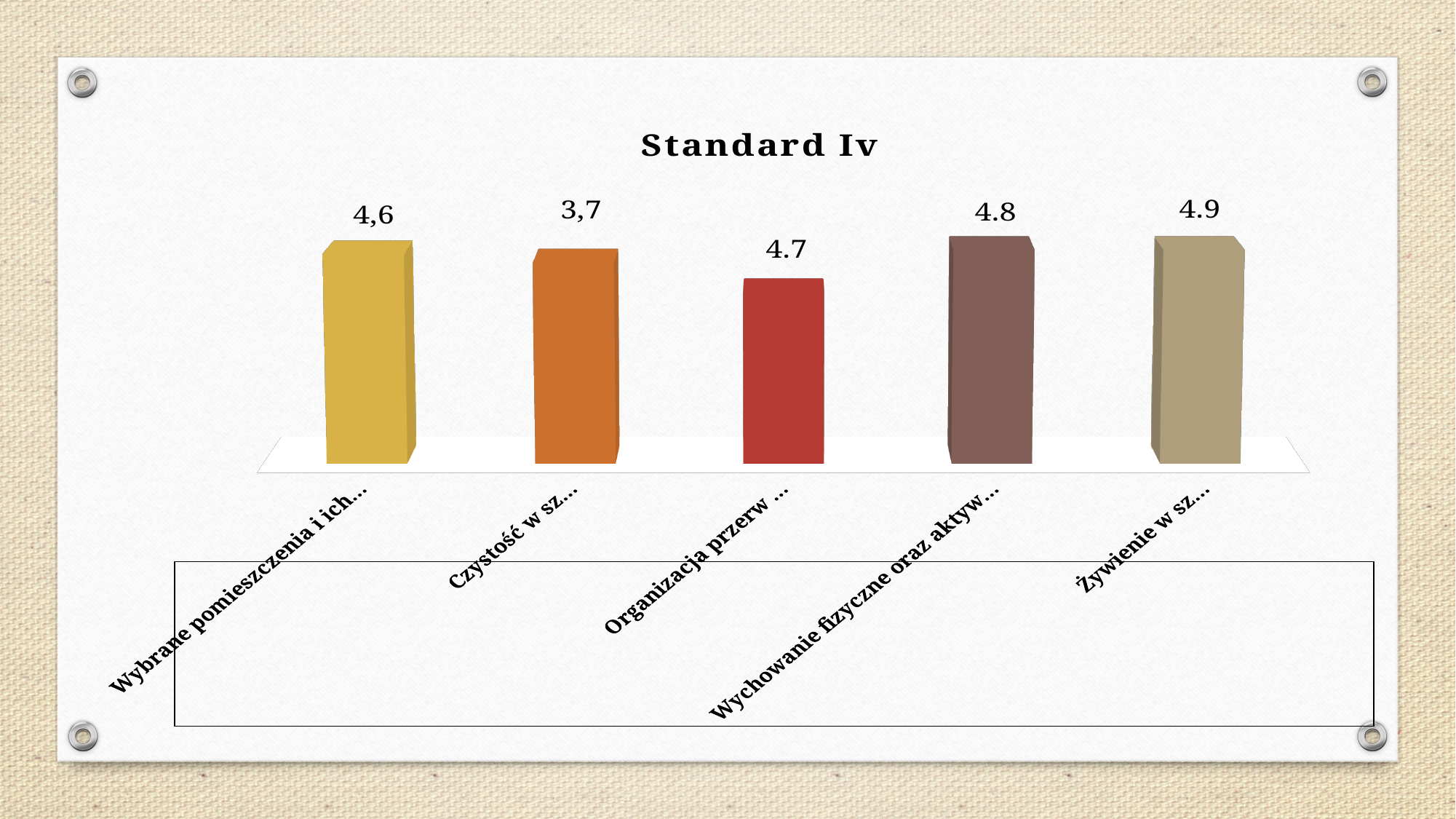
What is the value for the category labelled "Organizacja przerw ..."? 4.7 What kind of chart is shown on the slide? Bar chart What is the difference between the values for "Wychowanie fizyczne oraz aktyw..." and "Wybrane pomieszczenia i ich..."? 0.2 Which has the larger value, "Żywienie w sz..." or "Wybrane pomieszczenia i ich..."? Żywienie w sz... How many categories are shown in the chart? 5 What is the title of the chart? Standard Iv What is the difference between the values for "Żywienie w sz..." and "Czystość w sz..."? 1.2 What is the value for the category labelled "Czystość w sz..."? 3,7 What is the value for the category labelled "Wybrane pomieszczenia i ich..."? 4,6 Which category has the highest data label value? Żywienie w sz... What is the value for the category labelled "Wychowanie fizyczne oraz aktyw..."? 4.8 What is the value for the category labelled "Żywienie w sz..."? 4.9